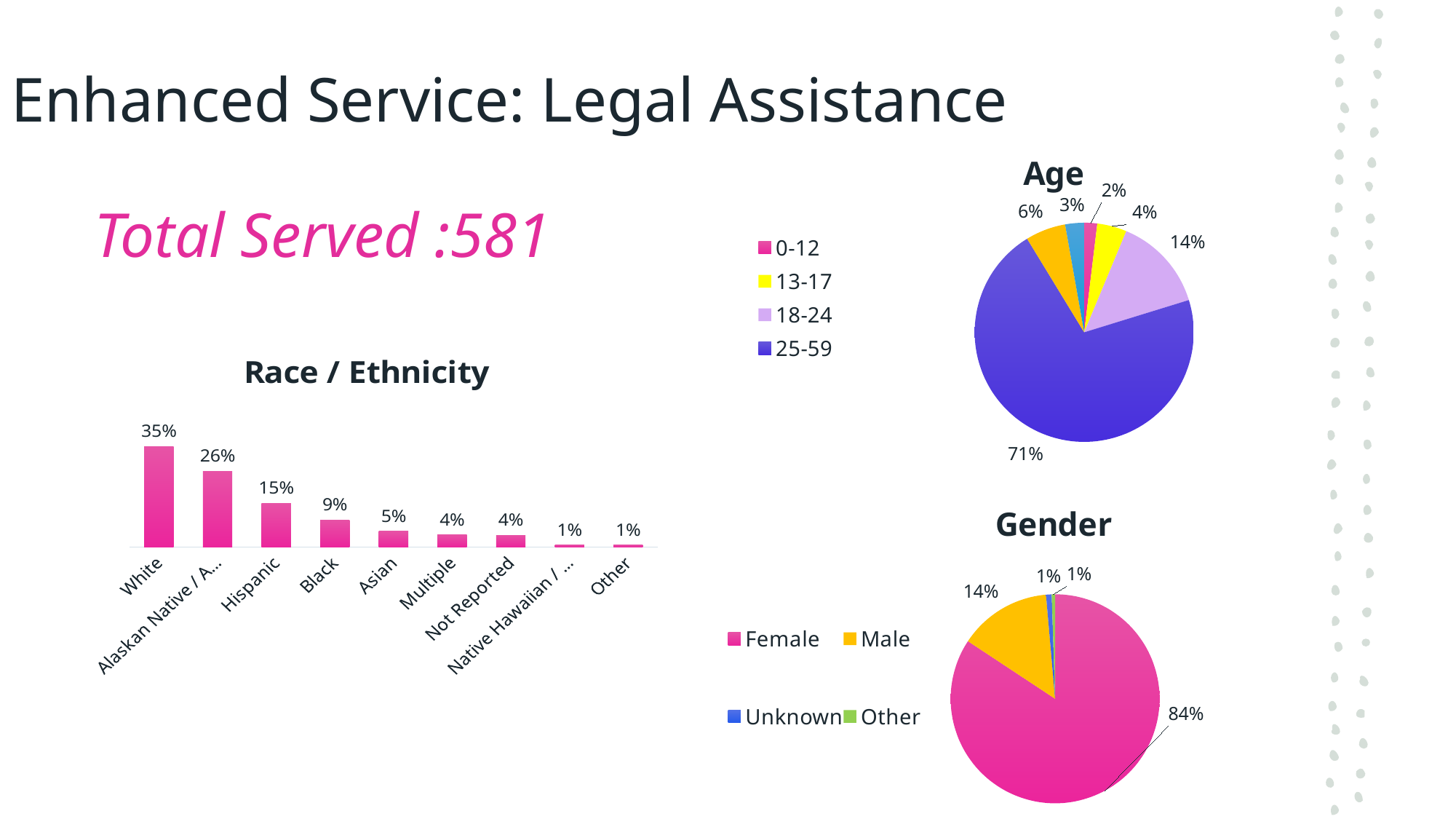
In the Gender pie chart, what share does the Female slice have? 84% In the Gender pie chart, which is larger, Female or Male? Female How many categories are shown in the Race / Ethnicity chart? 9 In the Race / Ethnicity chart, what is the difference between the values for White and Black? 26 percentage points What kind of chart is the Race / Ethnicity chart? Bar chart In the Age pie chart, what share does the 18-24 slice have? 14% How many entries does the legend of the Age pie chart list? 4 In the Race / Ethnicity chart, which category has the highest value? White In the Race / Ethnicity chart, what is the value for Hispanic? 15% In the Race / Ethnicity chart, what is the value for White? 35% In the Race / Ethnicity chart, do the values rise or fall from left to right along the x axis? Fall In the Age pie chart, what share does the 25-59 slice have? 71%